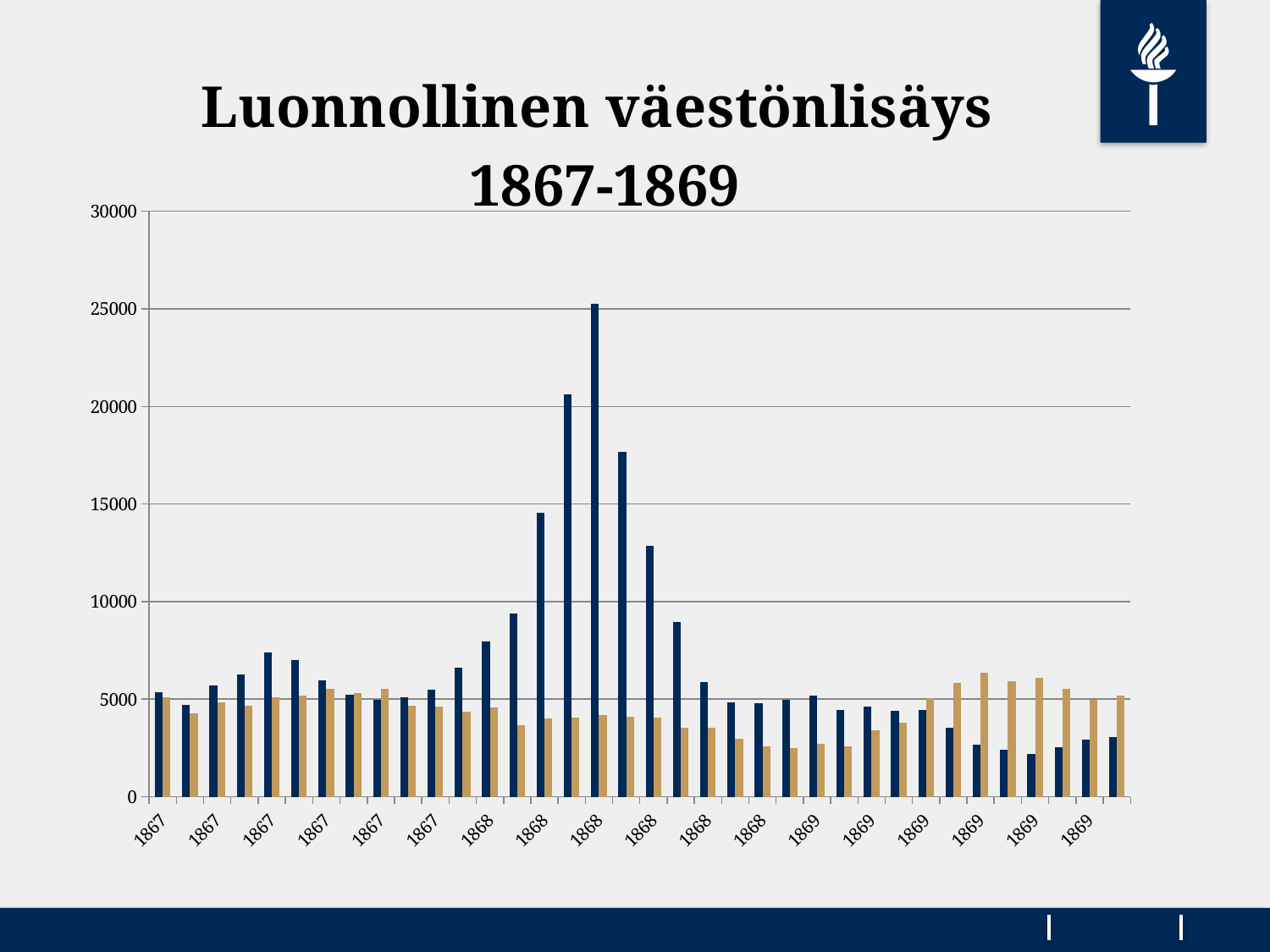
How many distinct years are labelled on the x axis of the chart? 3 What is the highest value shown on the y axis of the chart? 30000 What kind of chart is shown on the slide? bar chart In which year does the tallest bar of the chart occur? 1868 Which colour series contains the tallest bar in the chart, dark blue or gold? dark blue How many differently coloured bar series are plotted in the chart? 2 Is the shortest dark blue bar greater or less than 5000? less Is the tallest gold bar greater or less than 5000? greater Is the tallest gold bar greater or less than 10000? less What is the title of the chart? Luonnollinen väestönlisäys 1867-1869 Do the dark blue bars in 1868 rise to a peak and then fall, or do they rise steadily throughout the year? rise to a peak and then fall